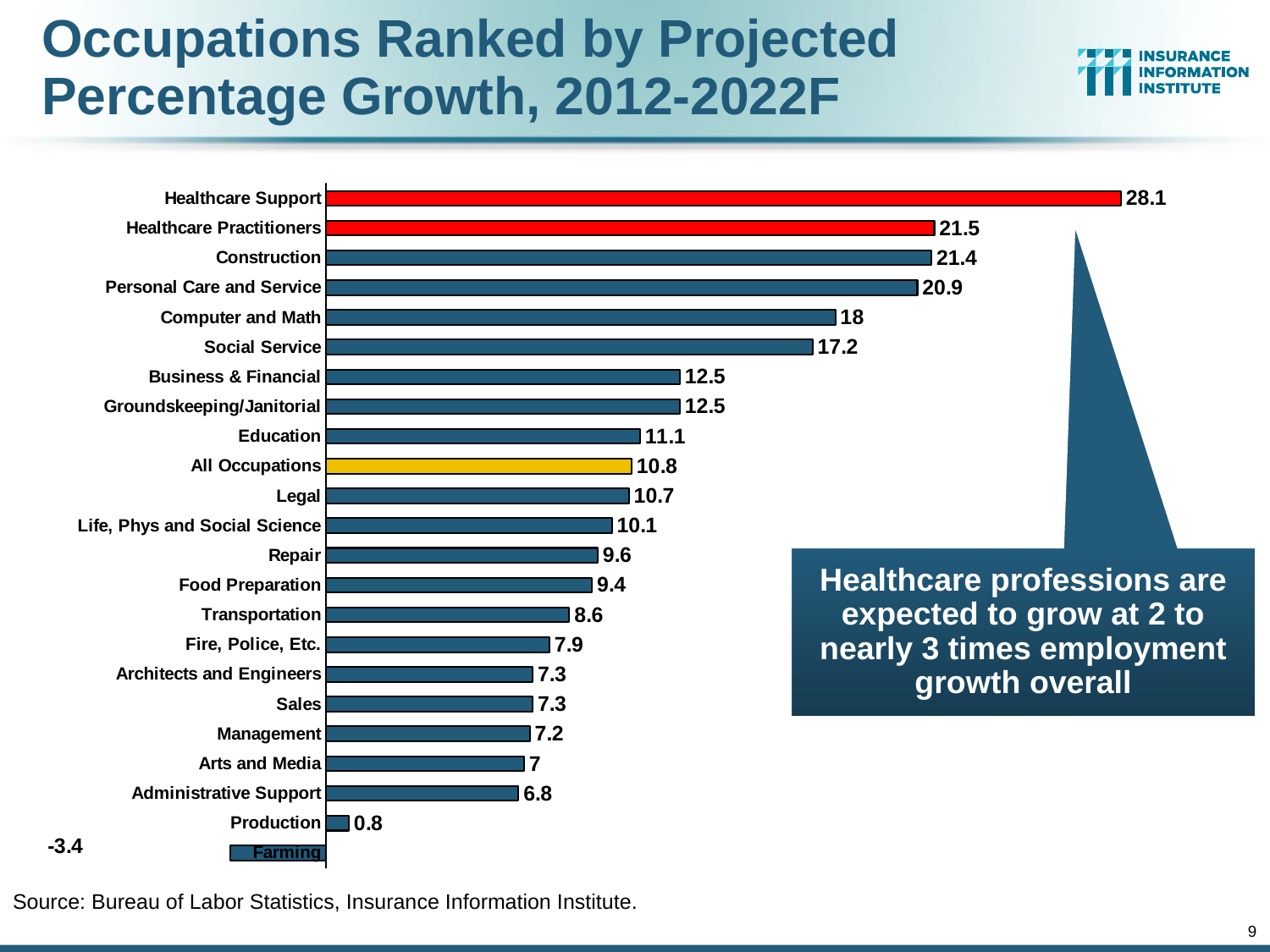
How many occupation categories are shown in the chart? 23 What is the projected percentage growth for Computer and Math? 18 What is the projected percentage growth for Farming? -3.4 Which bar in the chart is coloured yellow? All Occupations What is the difference between the projected growth for Construction and Production? 20.6 What is the difference between the projected growth for Healthcare Support and Healthcare Practitioners? 6.6 Which occupation has the highest projected percentage growth? Healthcare Support What is the projected percentage growth for All Occupations? 10.8 Which occupation has the lowest projected percentage growth? Farming Which has a higher projected percentage growth, Social Service or Education? Social Service What type of chart is shown on the slide? Bar chart What is the projected percentage growth for Healthcare Support? 28.1